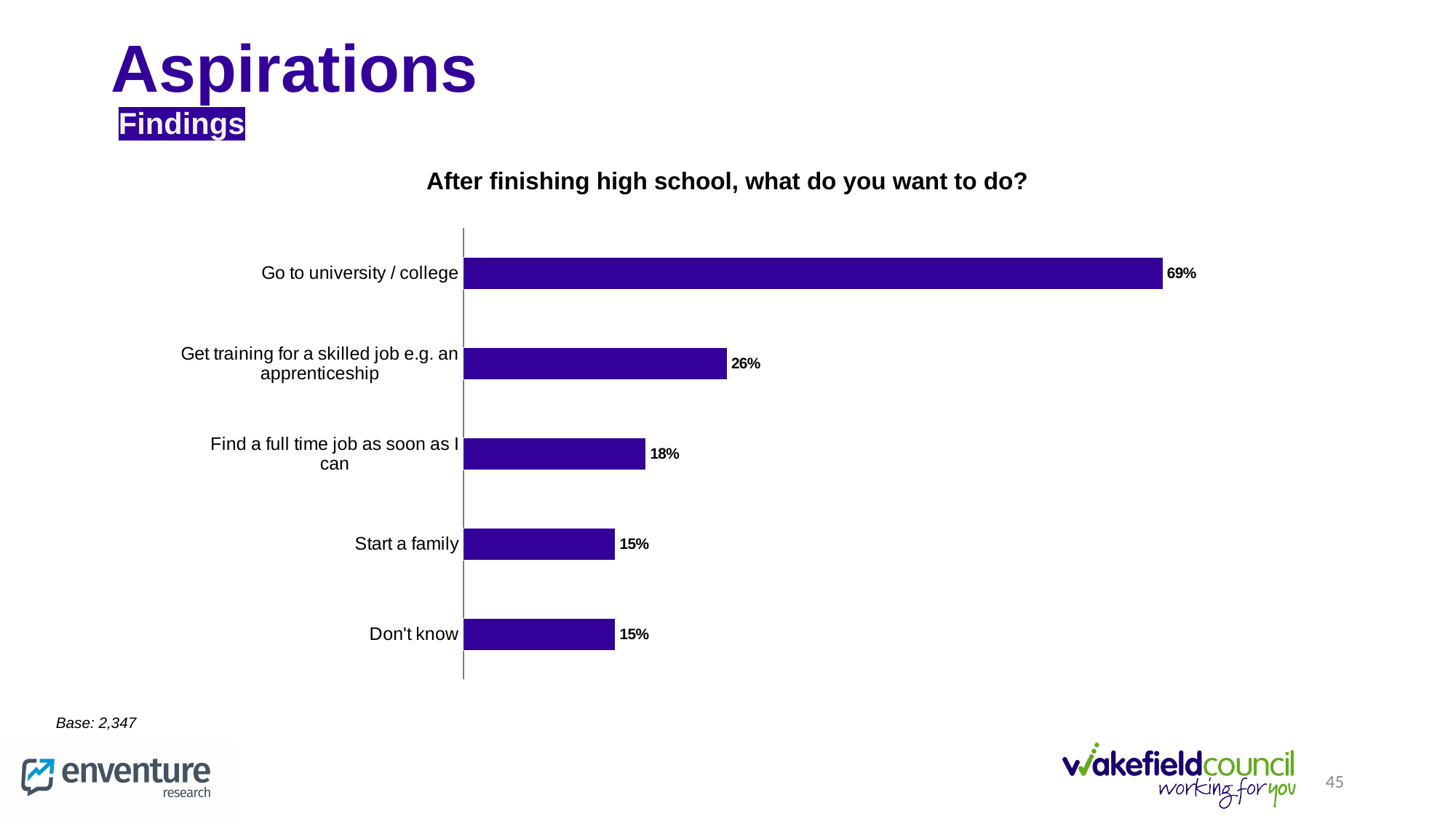
What is the title of the chart? After finishing high school, what do you want to do? How many categories are shown in the chart? 5 What percentage of respondents want to go to university / college after finishing high school? 69% What is the value for 'Get training for a skilled job e.g. an apprenticeship'? 26% Which is larger, the value for 'Find a full time job as soon as I can' or the value for 'Start a family'? Find a full time job as soon as I can What percentage of respondents want to find a full time job as soon as they can? 18% What is the difference between 'Go to university / college' and 'Get training for a skilled job e.g. an apprenticeship'? 43 percentage points What is the value for 'Start a family'? 15% Which category has the highest value? Go to university / college What is the difference between 'Get training for a skilled job e.g. an apprenticeship' and 'Find a full time job as soon as I can'? 8 percentage points What is the value for 'Don't know'? 15% What kind of chart is shown on the slide? Bar chart